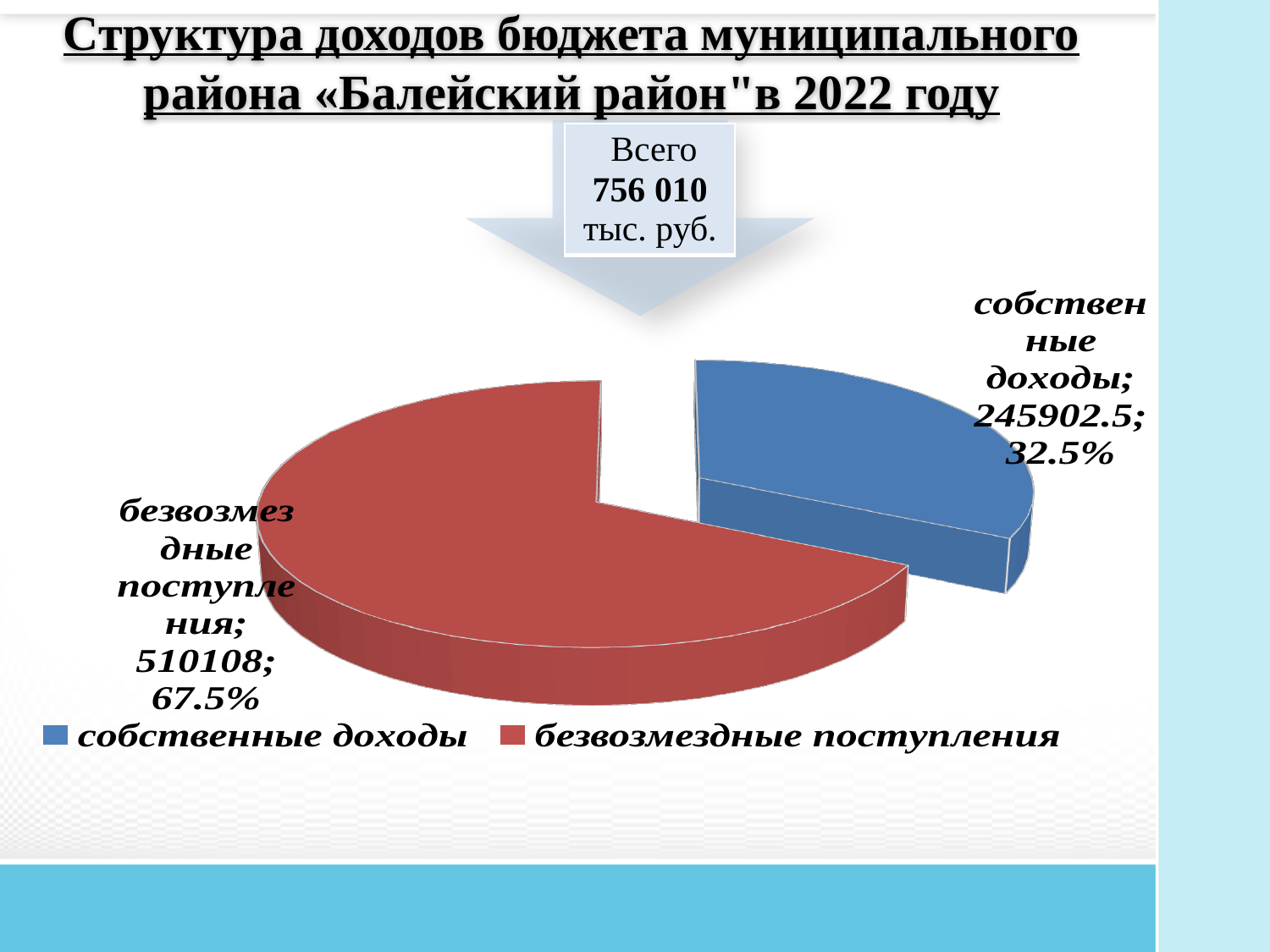
How many slices does the pie chart have? 2 What is the value for собственные доходы? 245902.5 Which is larger, собственные доходы or безвозмездные поступления? безвозмездные поступления Which category has the smallest slice? собственные доходы What share of the pie is собственные доходы? 32.5% What is the value for безвозмездные поступления? 510108 What kind of chart is shown on the slide? pie chart What total is shown in the box above the chart? 756 010 тыс. руб. What share of the pie is безвозмездные поступления? 67.5% What colour is the slice for собственные доходы? blue Which category has the largest slice? безвозмездные поступления What is the difference between безвозмездные поступления and собственные доходы? 264205.5